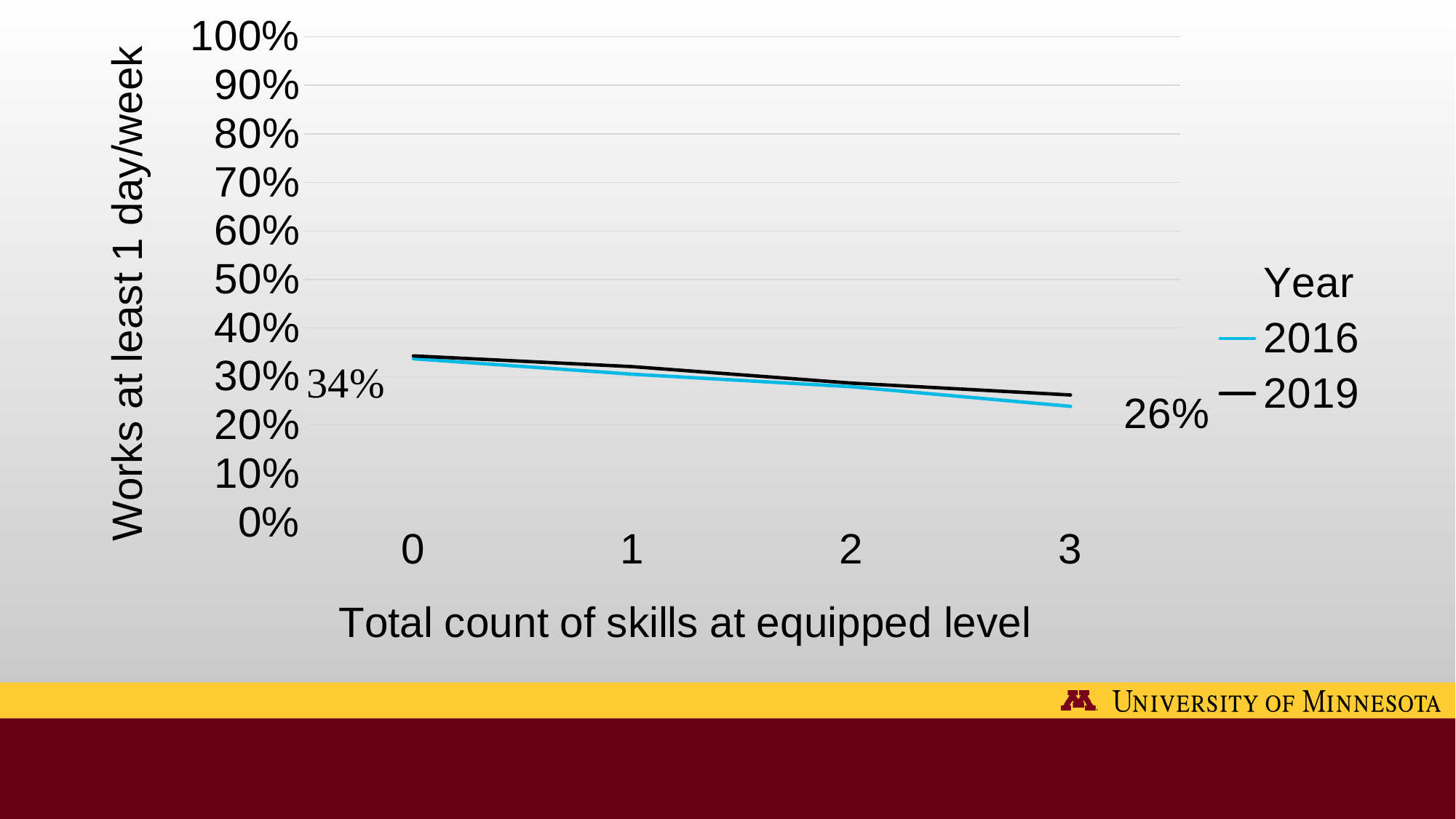
Do the values rise or fall as the total count of skills increases from 0 to 3? fall Is the value for 2019 at a skill count of 3 greater or less than 40%? less How many points are marked on the x axis? 4 What data label is printed at the end of the lines, at a skill count of 3? 26% What kind of chart is shown on the slide? line chart Is the value for 2016 at a skill count of 3 greater or less than 30%? less Is the value for 2019 at a skill count of 0 greater or less than 30%? greater What data label is printed at the start of the lines, at a skill count of 0? 34% What is the title of the x axis? Total count of skills at equipped level How many series does the legend list? 2 At a skill count of 3, which series has the higher value, 2016 or 2019? 2019 Which years are listed in the legend? 2016 and 2019